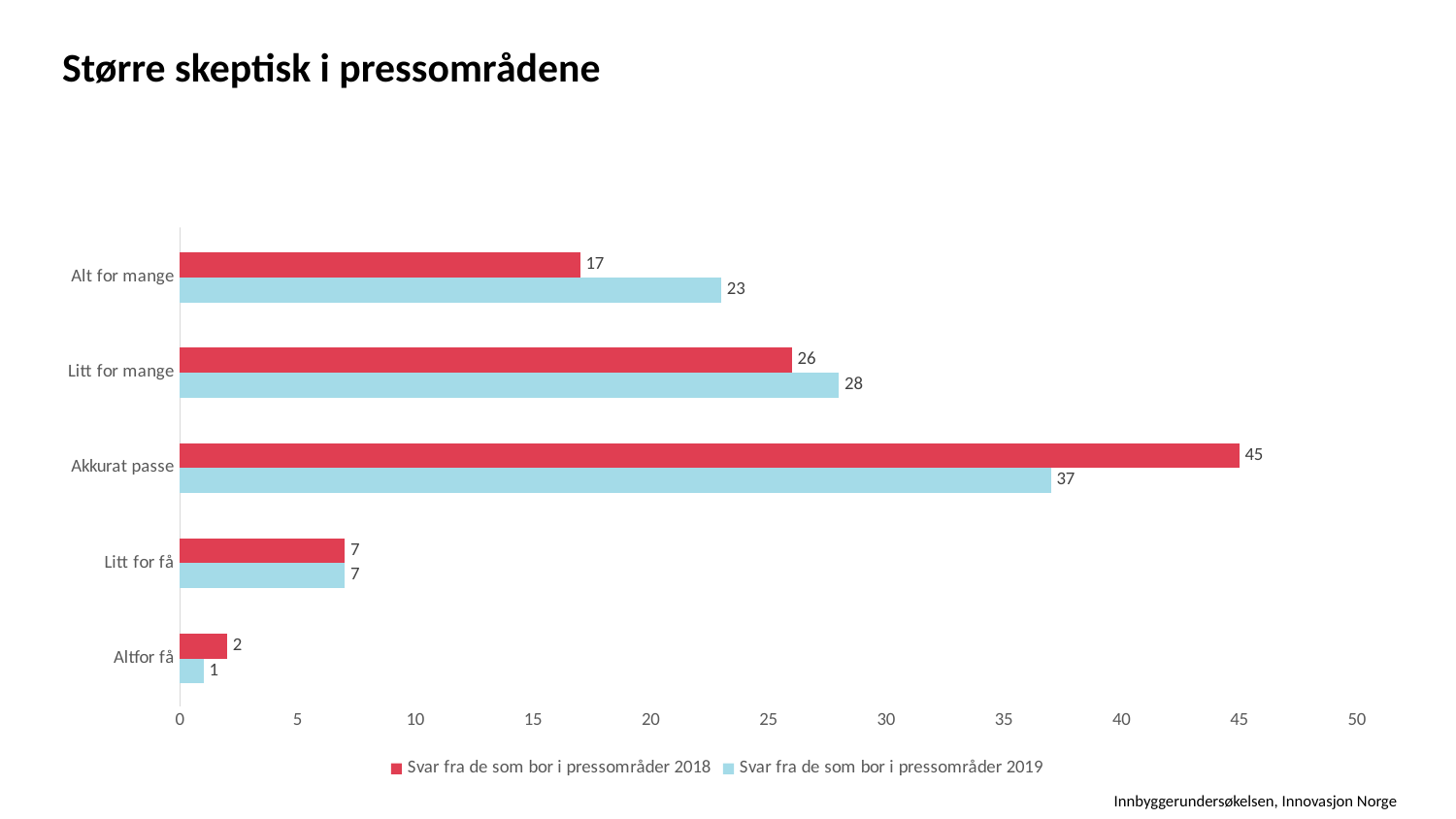
How many categories are shown on the chart? 5 Which is larger for "Alt for mange": the 2018 value or the 2019 value? 2019 What is the value for "Alt for mange" in the series "Svar fra de som bor i pressområder 2019"? 23 What is the title of the slide? Større skeptisk i pressområdene Which category has the highest value in the series "Svar fra de som bor i pressområder 2018"? Akkurat passe What is the value for "Litt for mange" in the series "Svar fra de som bor i pressområder 2019"? 28 Is the 2019 value for "Akkurat passe" greater or less than 40? less Which category has the lowest value in the series "Svar fra de som bor i pressområder 2019"? Altfor få What is the value for "Akkurat passe" in the series "Svar fra de som bor i pressområder 2018"? 45 How many series does the legend list? 2 What is the difference between the 2018 and 2019 values for "Akkurat passe"? 8 What kind of chart is shown on the slide? Bar chart